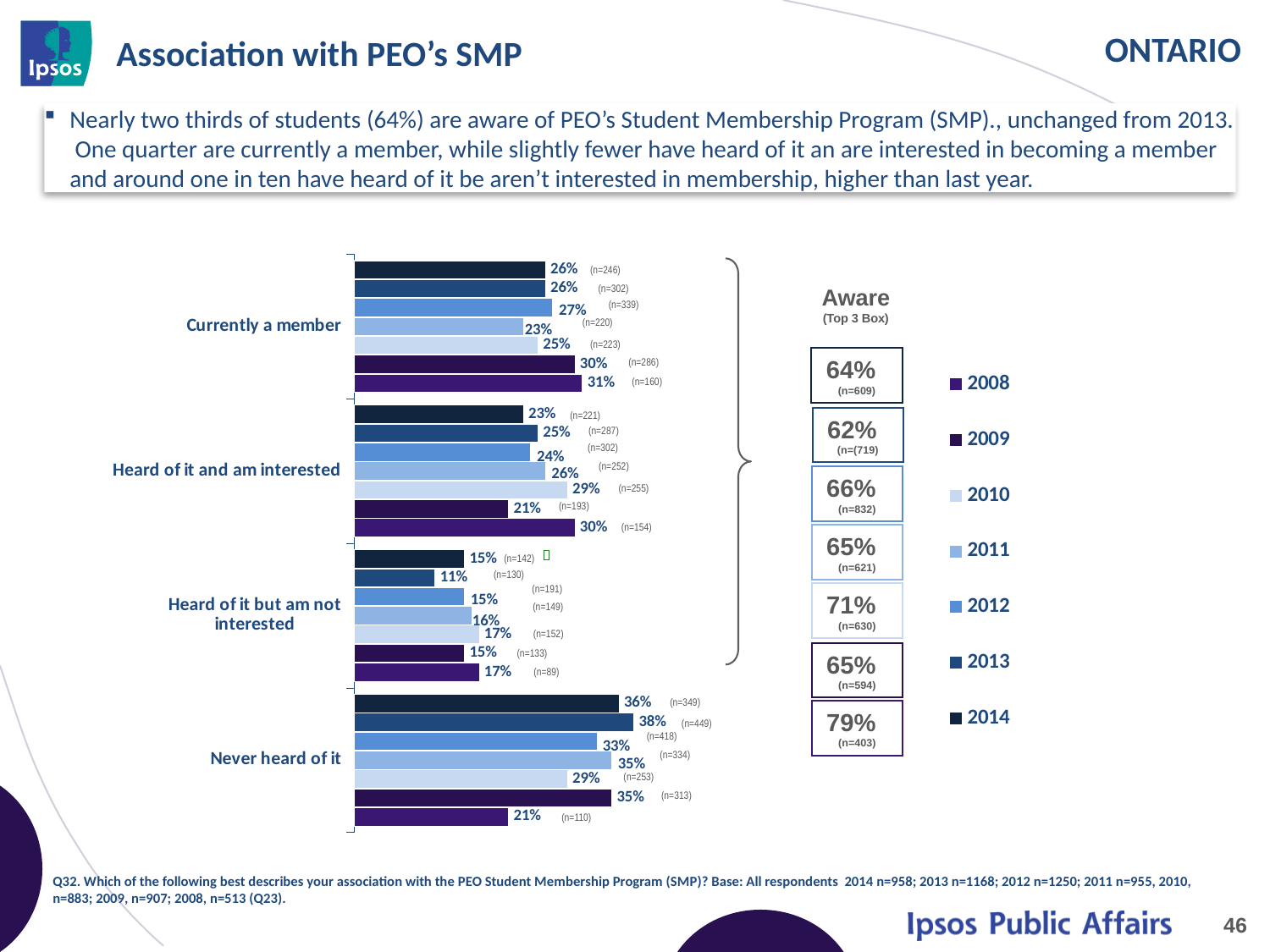
How many response categories are shown on the chart's vertical axis? 4 What is the lowest value shown among the bars for 'Never heard of it'? 21% Which is larger: the highest bar in 'Never heard of it' or the highest bar in 'Currently a member'? Never heard of it In the 'Aware (Top 3 Box)' column, what is the lowest percentage shown? 62% What is the lowest value shown among the bars for 'Heard of it but am not interested'? 11% What is the difference between the highest (38%) and lowest (21%) bars in the 'Never heard of it' group? 17 percentage points What is the highest value shown among the bars for 'Never heard of it'? 38% What is the highest value shown among the bars for 'Currently a member'? 31% What range of years does the chart legend cover? 2008 to 2014 How many years (series) does the legend list? 7 In the 'Aware (Top 3 Box)' column, what is the highest percentage shown? 79% What kind of chart is used to show association with PEO's SMP? Bar chart